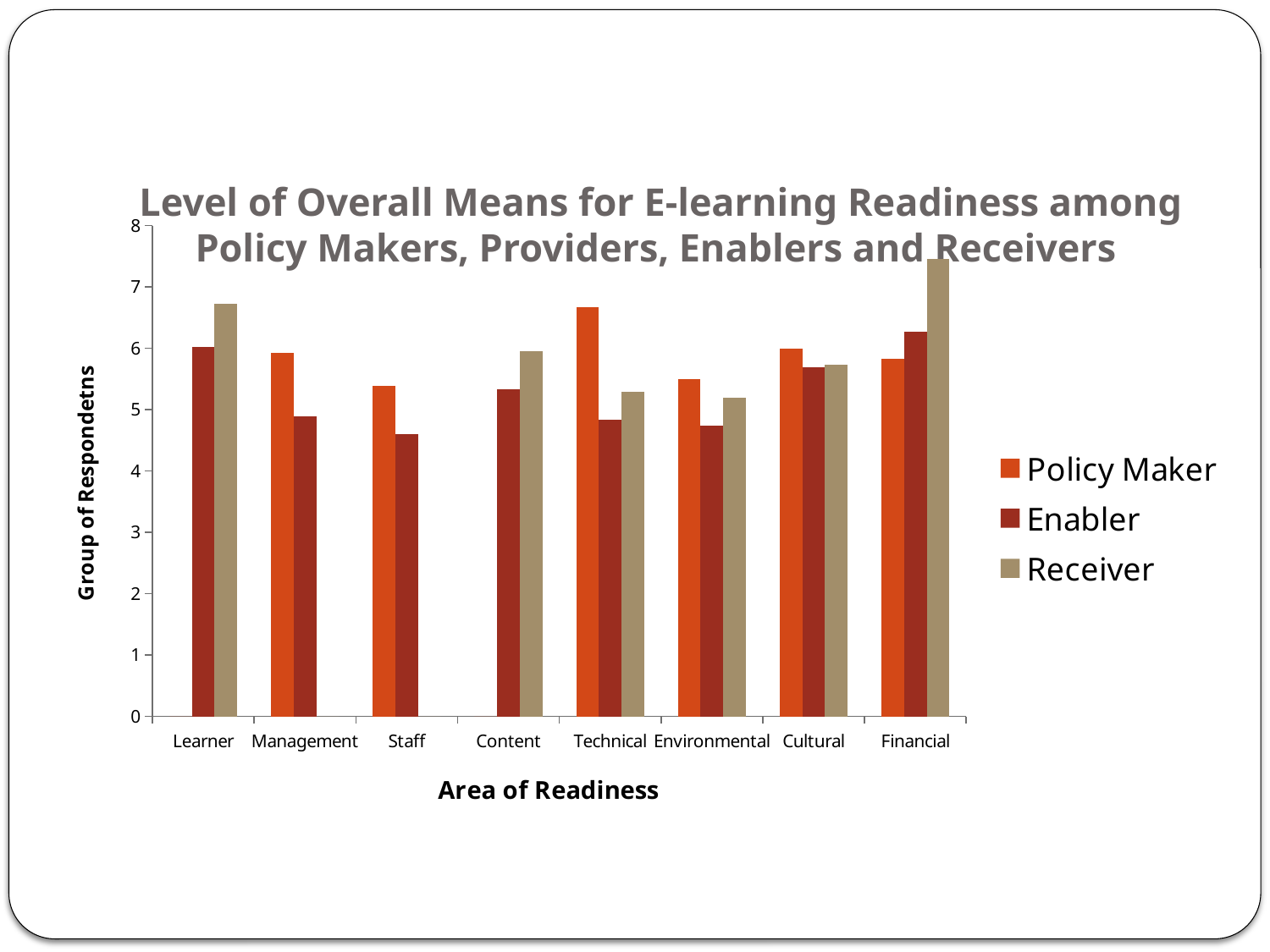
Is the Enabler value for Staff greater or less than 5? less For which area of readiness is the Policy Maker value highest? Technical How many series does the legend list? 3 How many areas of readiness are shown on the x axis? 8 For which area of readiness is the Receiver value highest? Financial Is the Policy Maker value for Management greater or less than 5? greater For Financial, which is larger: the Receiver value or the Policy Maker value? Receiver What kind of chart is shown on the slide? Bar chart Is the Receiver value for Financial greater or less than 7? greater What is the title of the x axis? Area of Readiness For Learner, which is larger: the Receiver value or the Enabler value? Receiver For Technical, which is larger: the Policy Maker value or the Enabler value? Policy Maker